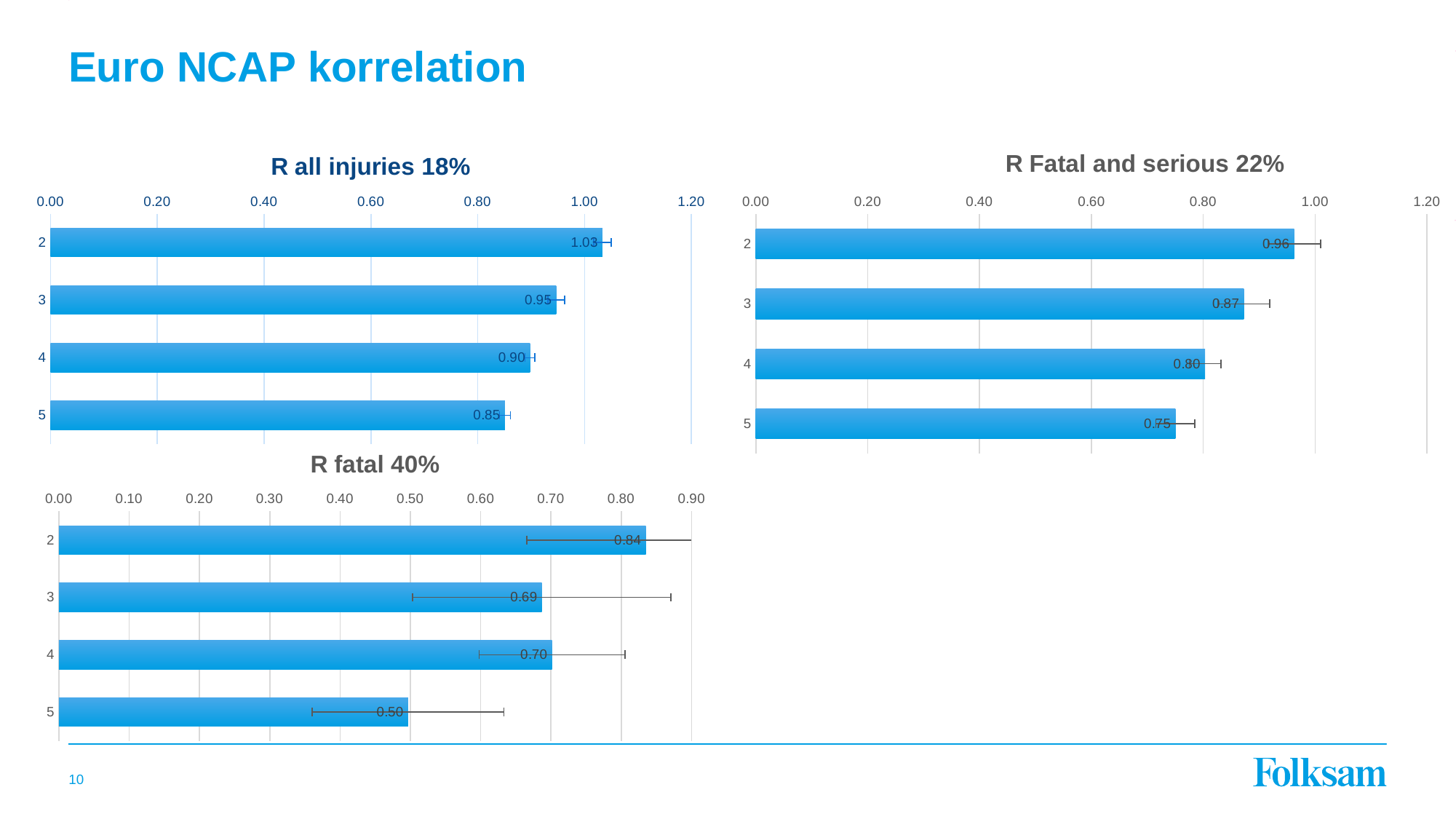
In the 'R fatal 40%' chart, what is the value for category 5? 0.50 In the 'R fatal 40%' chart, which is larger, the value for category 2 or the value for category 4? category 2 In the 'R fatal 40%' chart, which category has the lowest value? 5 What type of chart is 'R Fatal and serious 22%'? bar chart In the 'R Fatal and serious 22%' chart, which category has the highest value? 2 In the 'R all injuries 18%' chart, what is the value for category 2? 1.03 In the 'R fatal 40%' chart, what is the difference between the values for category 2 and category 3? 0.15 In the 'R all injuries 18%' chart, which category has the lowest value? 5 How many categories are shown in the 'R all injuries 18%' chart? 4 In the 'R Fatal and serious 22%' chart, do the values rise or fall going from category 2 down to category 5? fall In the 'R Fatal and serious 22%' chart, what is the value for category 4? 0.80 In the 'R all injuries 18%' chart, what is the difference between the values for category 2 and category 5? 0.18